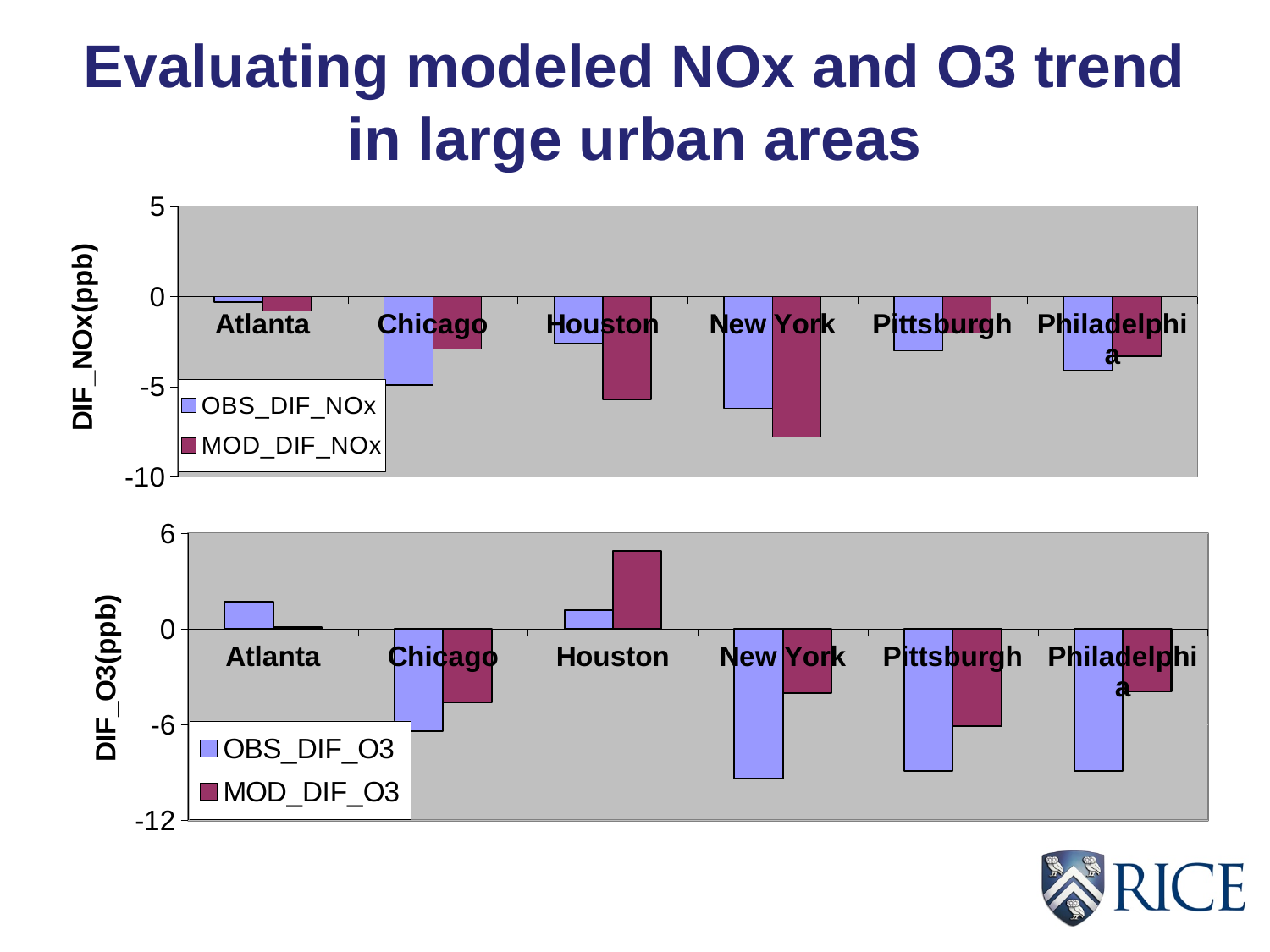
In the top chart (DIF_NOx), which city has the lowest MOD_DIF_NOx value? New York How many series does the legend of the top chart (DIF_NOx) list? 2 What is the y-axis title of the bottom chart? DIF_O3(ppb) In the bottom chart (DIF_O3), which is larger for Chicago, OBS_DIF_O3 or MOD_DIF_O3? MOD_DIF_O3 In the top chart (DIF_NOx), is the MOD_DIF_NOx value for New York greater or less than -5? less How many cities are shown on the x axis of the bottom chart (DIF_O3)? 6 In the bottom chart (DIF_O3), which city has the highest MOD_DIF_O3 value? Houston In the bottom chart (DIF_O3), is the OBS_DIF_O3 value for New York greater or less than -6? less What kind of chart is the top chart (DIF_NOx)? bar chart In the top chart (DIF_NOx), which is larger for Houston, OBS_DIF_NOx or MOD_DIF_NOx? OBS_DIF_NOx In the top chart (DIF_NOx), which city has the lowest OBS_DIF_NOx value? New York